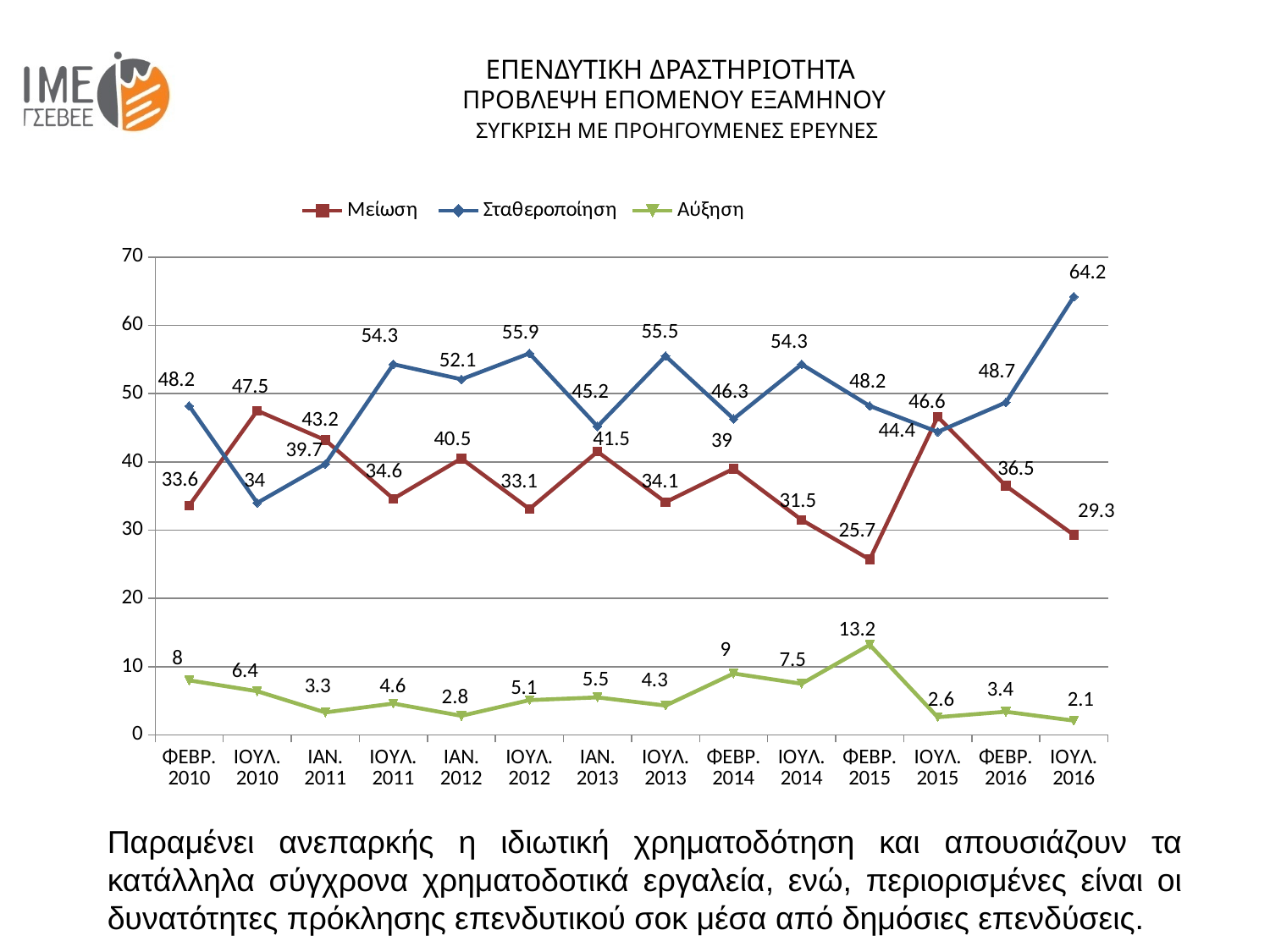
How many time periods are shown on the x axis? 14 What is the value of Σταθεροποίηση for ΙΟΥΛ. 2016? 64.2 Does Μείωση rise or fall from ΙΟΥΛ. 2015 to ΙΟΥΛ. 2016? fall What is the value of Μείωση for ΦΕΒΡ. 2015? 25.7 Which is larger in ΙΟΥΛ. 2010, Μείωση or Σταθεροποίηση? Μείωση What kind of chart is shown on the slide? line chart In which period does Σταθεροποίηση have its lowest value? ΙΟΥΛ. 2010 What is the difference between Σταθεροποίηση and Μείωση in ΙΟΥΛ. 2016? 34.9 How many series does the legend list? 3 In which period does Αύξηση reach its highest value? ΦΕΒΡ. 2015 Is the value of Μείωση for ΙΟΥΛ. 2015 greater or less than 40? greater What is the value of Αύξηση for ΦΕΒΡ. 2014? 9